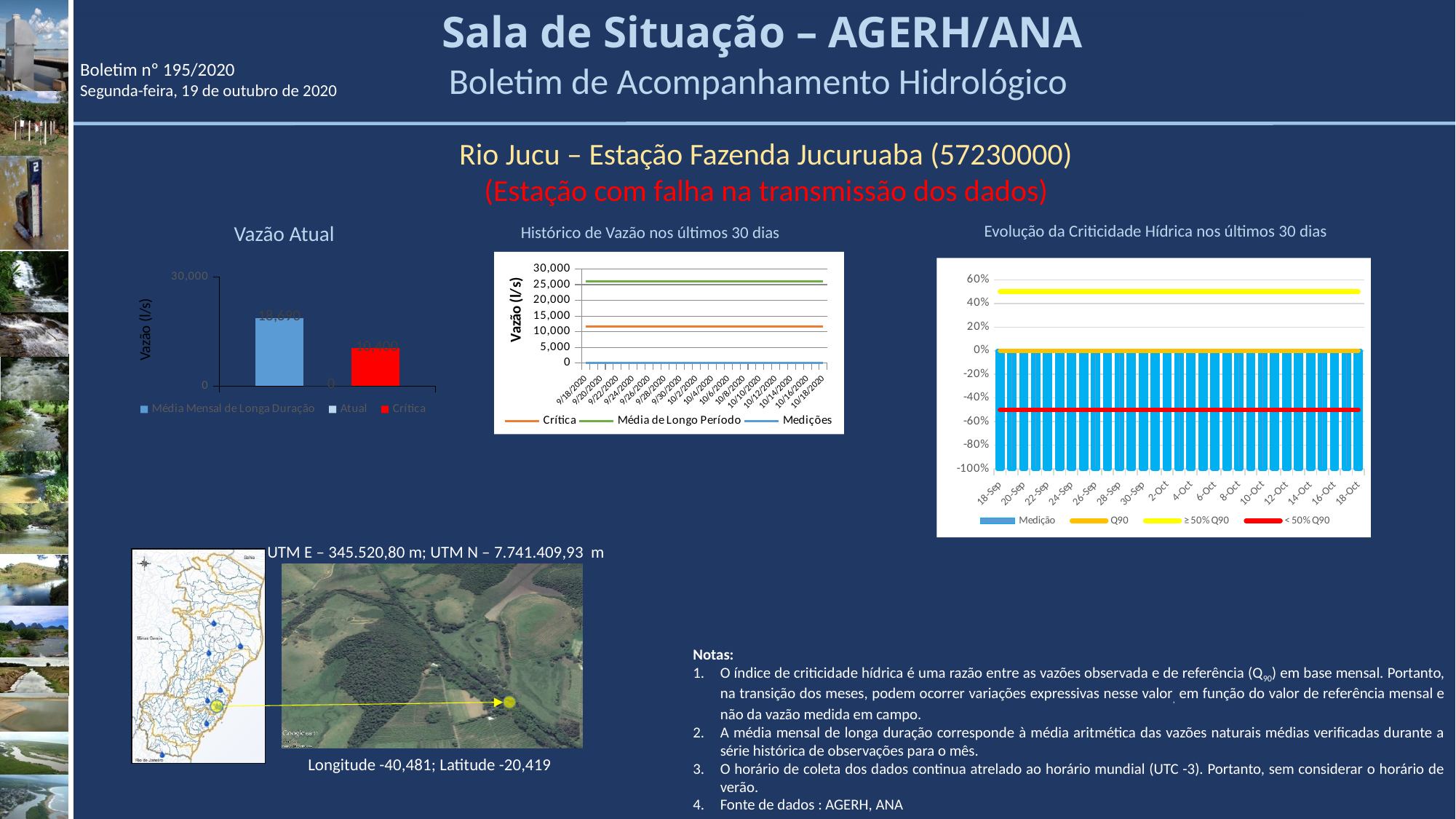
In the 'Histórico de Vazão nos últimos 30 dias' chart, how many series does the legend list? 3 In the 'Vazão Atual' chart, how many series does the legend list? 3 In the 'Histórico de Vazão nos últimos 30 dias' chart, is the Crítica line greater or less than 10,000? greater In the 'Evolução da Criticidade Hídrica nos últimos 30 dias' chart, at what value does the Q90 line sit? 0% In the 'Evolução da Criticidade Hídrica nos últimos 30 dias' chart, how many series does the legend list? 4 In the 'Vazão Atual' chart, is the Média Mensal de Longa Duração bar greater or less than 30,000? less In the 'Histórico de Vazão nos últimos 30 dias' chart, does the Crítica line rise, fall or stay flat over the 30 days? stays flat What kind of chart is the 'Vazão Atual' chart? bar chart In the 'Vazão Atual' chart, which bar is taller: Média Mensal de Longa Duração or Crítica? Média Mensal de Longa Duração In the 'Vazão Atual' chart, what is the value shown for Atual? 0 In the 'Evolução da Criticidade Hídrica nos últimos 30 dias' chart, is the '< 50% Q90' line greater or less than -40%? less